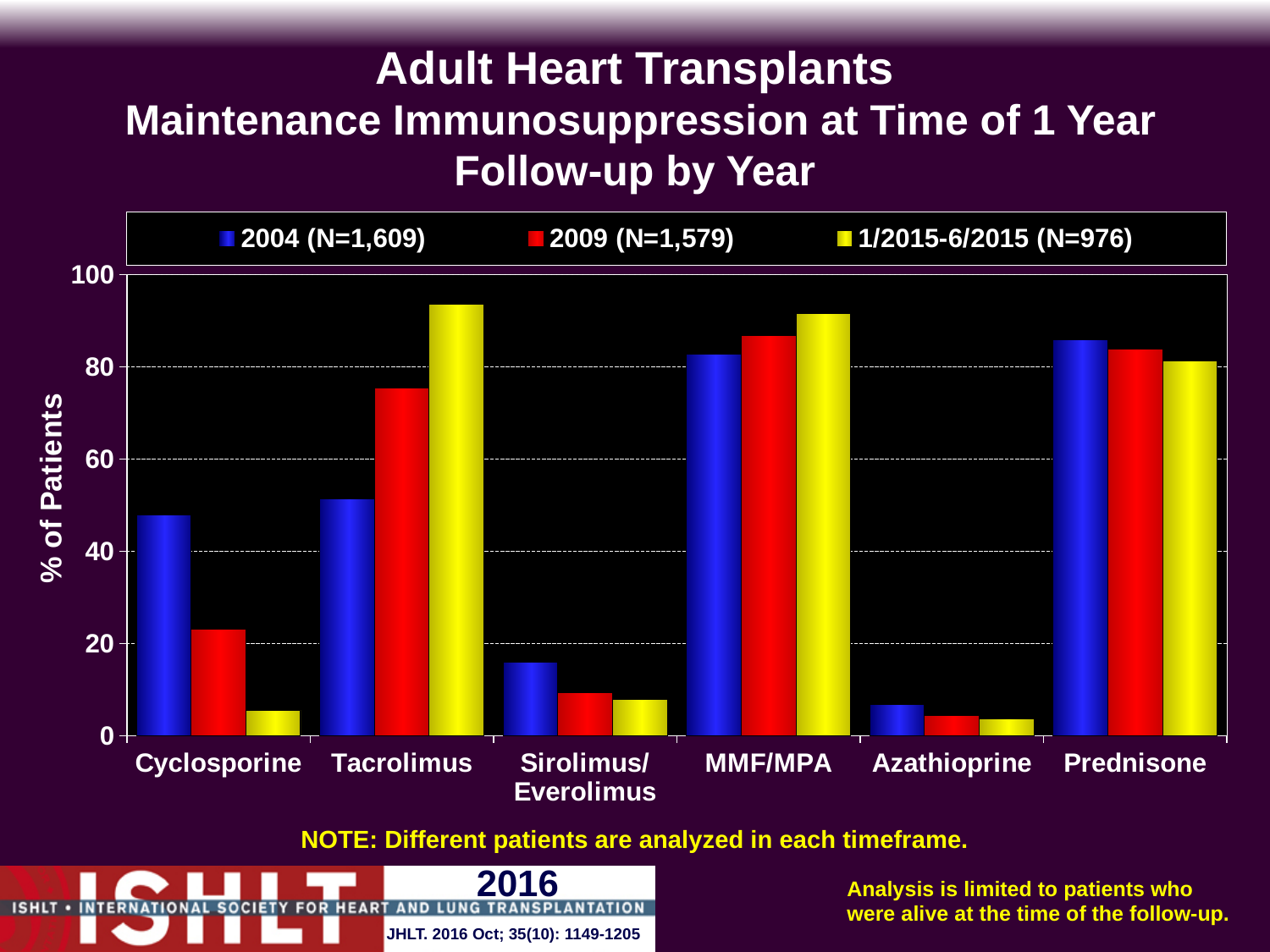
Is the 2004 value for Cyclosporine greater or less than 40? greater Does the value for Tacrolimus rise or fall from 2004 to 1/2015-6/2015? rise What is the N shown in the legend for the 2004 series? 1,609 How many series does the legend list? 3 Is the 1/2015-6/2015 value for Tacrolimus greater or less than 80? greater Which is larger for Cyclosporine, the 2004 value or the 2009 value? 2004 Does the value for Cyclosporine rise or fall from 2004 to 1/2015-6/2015? fall How many drug categories are shown on the x axis? 6 Which category has the lowest 2004 value? Azathioprine What kind of chart is shown on the slide? bar chart Which is larger for 1/2015-6/2015, Tacrolimus or Cyclosporine? Tacrolimus Is the 2009 value for Sirolimus/Everolimus greater or less than 20? less